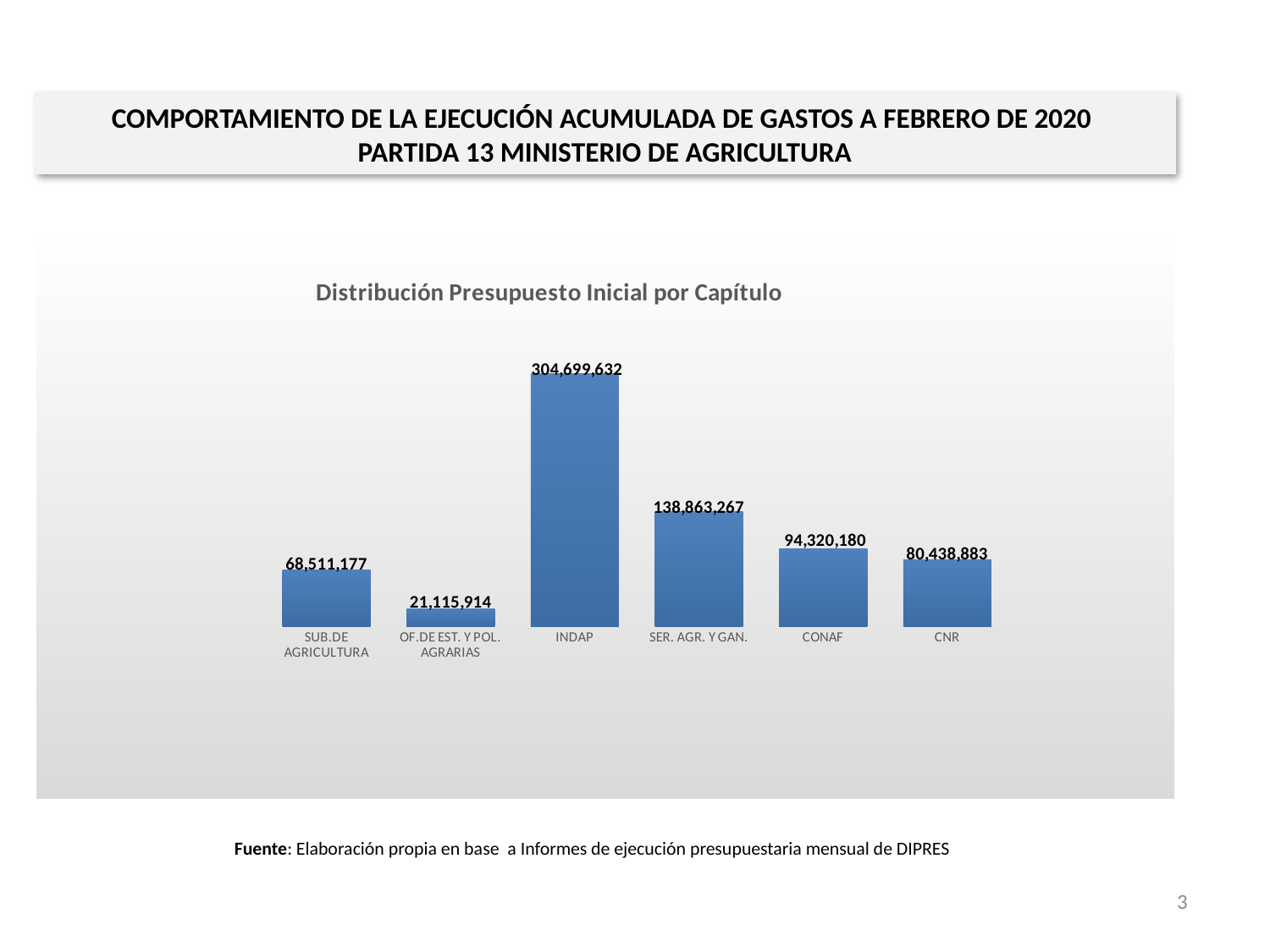
What is the value for CONAF? 94,320,180 What is the value for OF.DE EST. Y POL. AGRARIAS? 21,115,914 What is the value for CNR? 80,438,883 Which category has the lowest value? OF.DE EST. Y POL. AGRARIAS What is the value for INDAP? 304,699,632 Which category has the highest value? INDAP Which is larger, the value for SUB.DE AGRICULTURA or the value for CNR? CNR How many categories are shown in the chart? 6 What is the difference between the values for INDAP and SER. AGR. Y GAN.? 165,836,365 What kind of chart is shown on the slide? Bar chart What is the title of the chart? Distribución Presupuesto Inicial por Capítulo What is the difference between the values for CONAF and CNR? 13,881,297